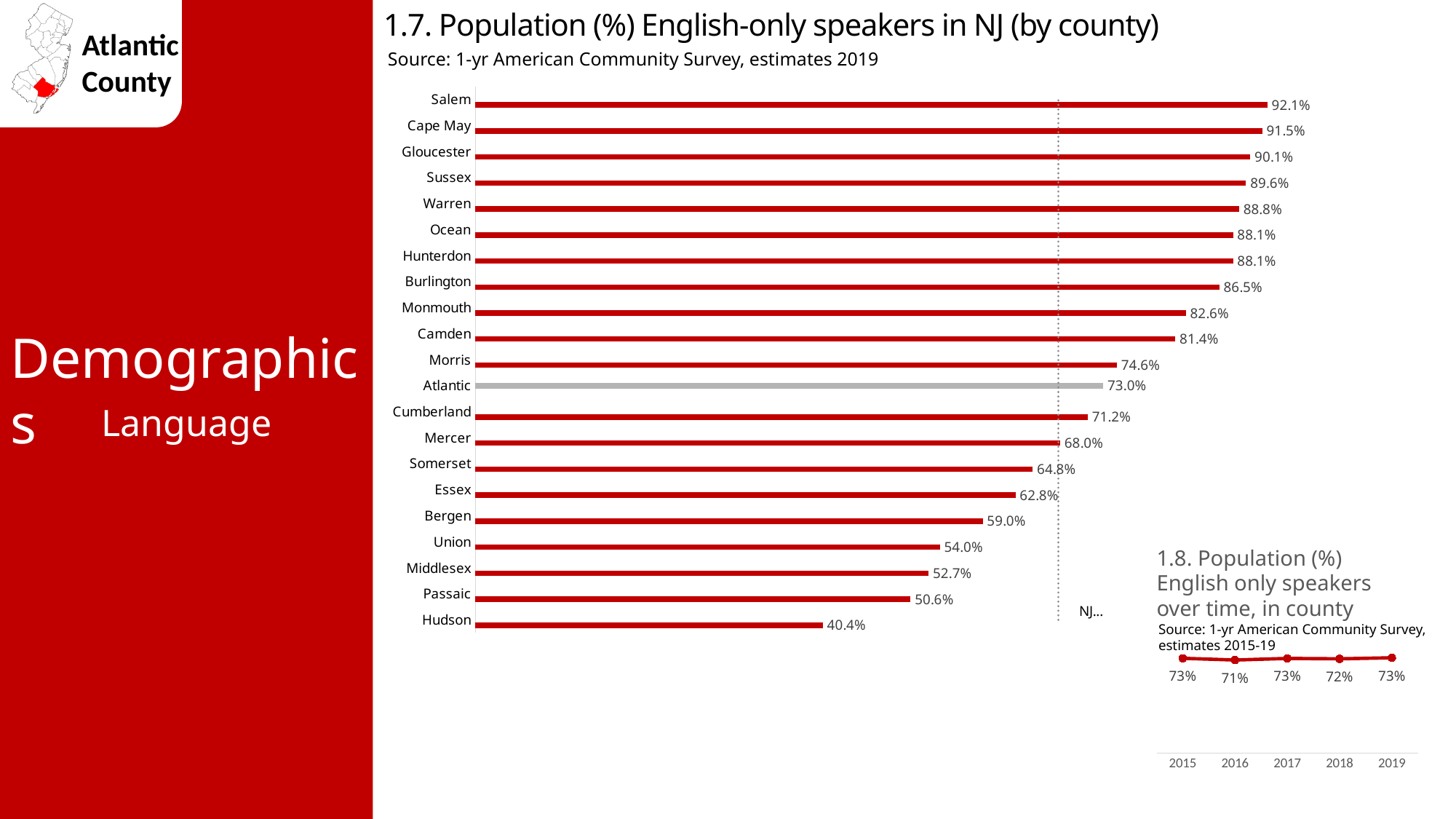
In chart 1.7, which county has the highest value? Salem In chart 1.7, what is the difference between Salem and Hudson? 51.7% In chart 1.7, which is larger, the value for Morris or the value for Cumberland? Morris In chart 1.7, which county has the lowest value? Hudson In chart 1.7, what is the value for Atlantic? 73.0% In chart 1.8, how many years are plotted? 5 What kind of chart is chart 1.7? Bar chart In chart 1.7, what is the value for Hudson? 40.4% What kind of chart is chart 1.8? Line chart In chart 1.7, how many counties are plotted? 21 In chart 1.8, what is the value for 2016? 71% In chart 1.7, which bar is shown in grey instead of red? Atlantic